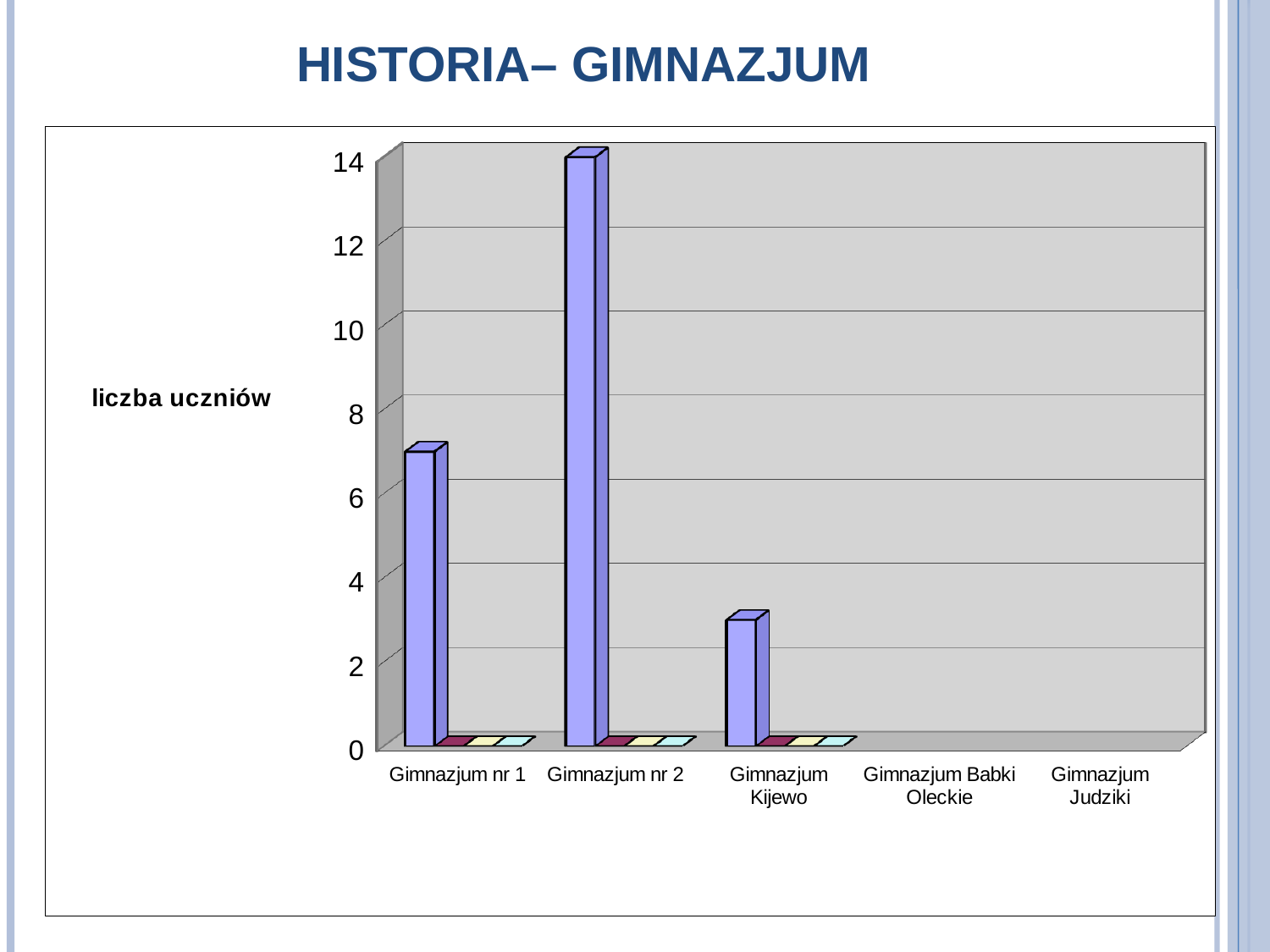
How many categories are shown on the x axis of the chart? 5 Is the value for Gimnazjum Kijewo greater or less than 2? greater What is the value for Gimnazjum nr 2? 14 What kind of chart is shown on the slide? bar chart Which is larger, the value for Gimnazjum nr 2 or the value for Gimnazjum nr 1? Gimnazjum nr 2 Is the value for Gimnazjum nr 1 greater or less than 8? less What is the label on the vertical axis of the chart? liczba uczniów Is the value for Gimnazjum nr 1 greater or less than 6? greater Which is larger, the value for Gimnazjum nr 1 or the value for Gimnazjum Kijewo? Gimnazjum nr 1 Which category has the highest value in the chart? Gimnazjum nr 2 What is the title of the slide above the chart? HISTORIA– GIMNAZJUM